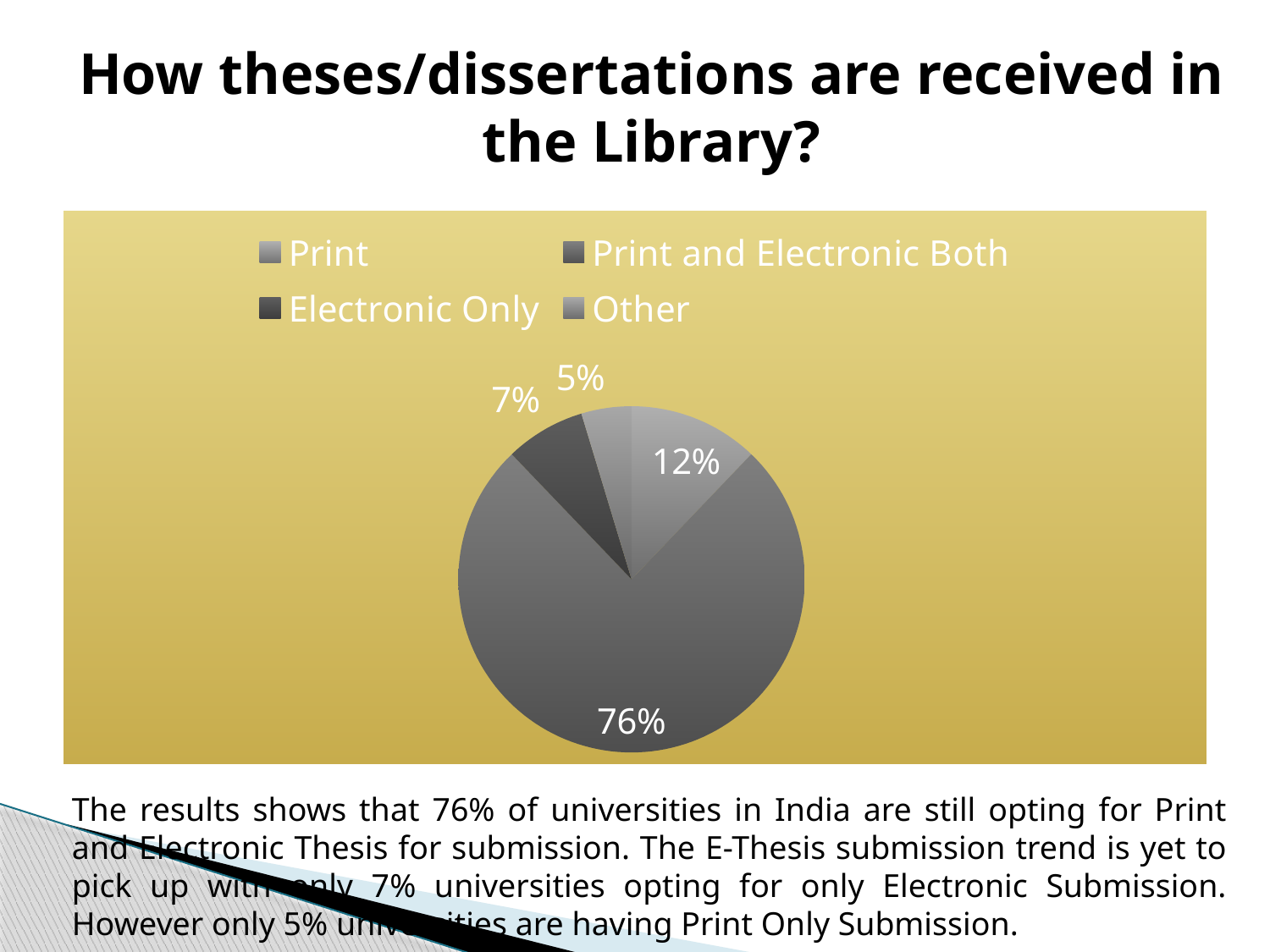
What percentage of the pie is labelled for Print and Electronic Both? 76% Which is larger, the slice for Electronic Only or the slice for Other? Electronic Only Which category has the largest slice of the pie? Print and Electronic Both What percentage of the pie is labelled for Other? 5% What percentage of the pie is labelled for Electronic Only? 7% Which category has the smallest slice of the pie? Other What is the title of the slide containing the pie chart? How theses/dissertations are received in the Library? What type of chart is shown on the slide? pie chart What is the combined share of Print and Electronic Only? 19% How many categories does the legend list? 4 What is the difference in percentage points between Print and Electronic Both and Other? 71 What percentage of the pie is labelled for Print? 12%